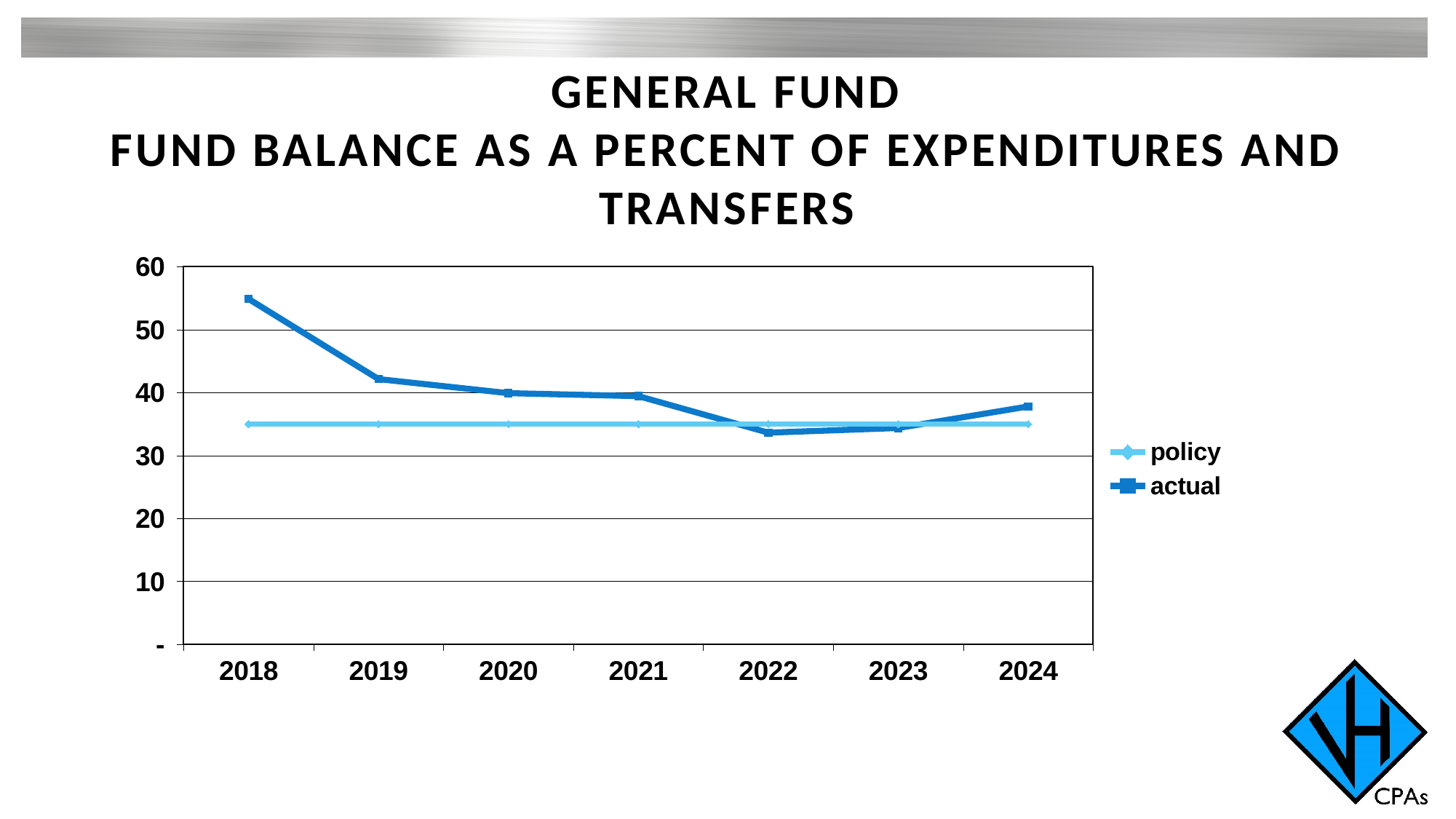
In which year is the actual value highest? 2018 Which is larger, the actual value for 2018 or the actual value for 2024? 2018 Is the actual value for 2018 greater or less than 50? greater How many series does the legend list? 2 Is the actual value for 2022 greater or less than 30? greater What are the two series named in the legend? policy and actual Is the actual value for 2019 greater or less than 40? greater How many years are shown on the x axis? 7 Does the actual series rise or fall from 2018 to 2022? fall What kind of chart is shown on the slide? line chart